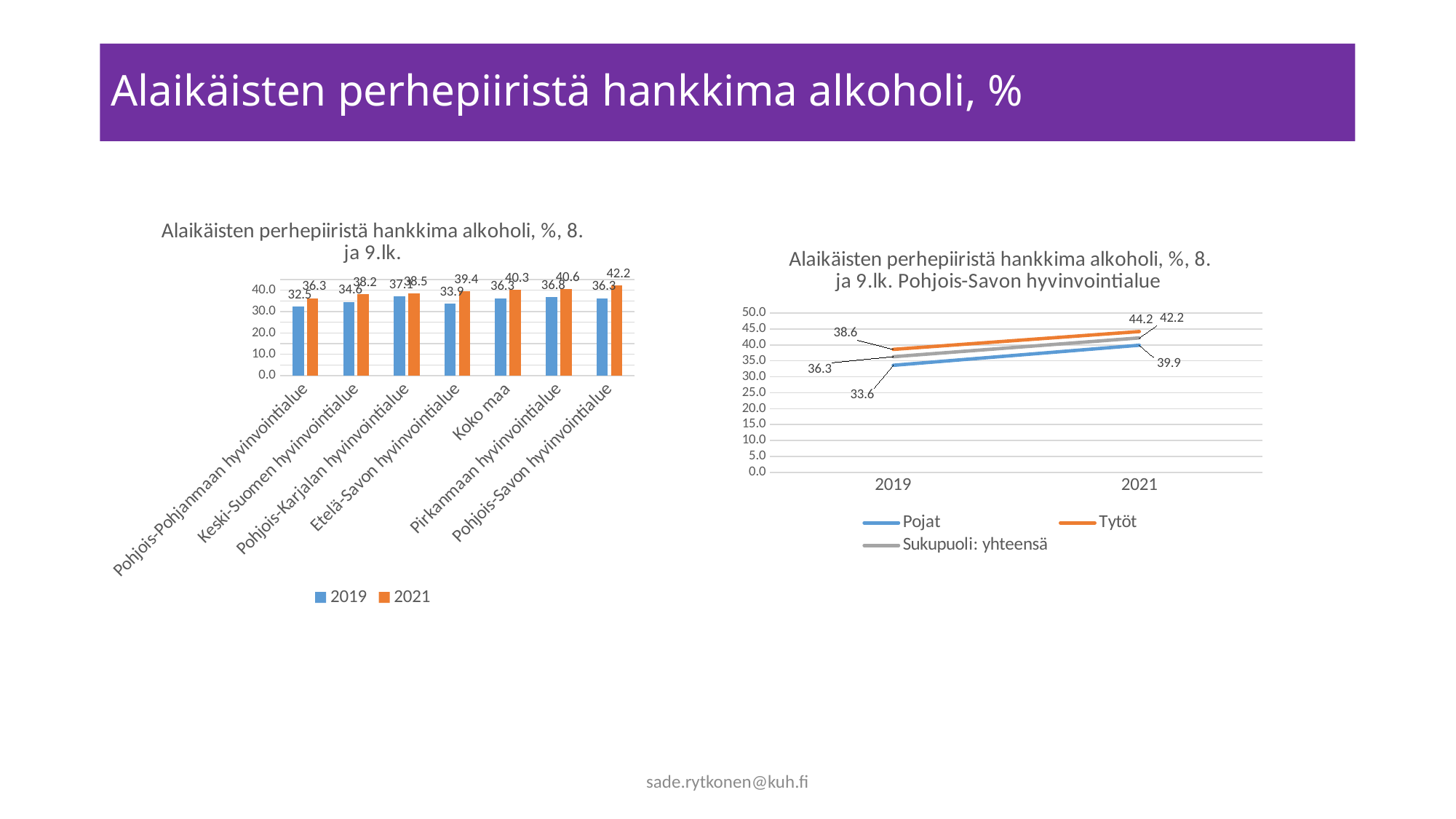
In the left chart, how many categories are shown on the x axis? 7 In the left chart, is the 2021 value for Koko maa greater or less than 40.0? greater What kind of chart is the chart on the right? line chart In the right chart, how many series does the legend list? 3 In the left chart, what is the 2019 value for Pohjois-Pohjanmaan hyvinvointialue? 32.5 In the right chart, what is the value for Tytöt in 2021? 44.2 In the left chart, which category has the highest 2021 value? Pohjois-Savon hyvinvointialue In the right chart, does the Pojat line rise or fall from 2019 to 2021? rise In the left chart, which category has the lowest 2019 value? Pohjois-Pohjanmaan hyvinvointialue In the right chart, what is the value for Pojat in 2019? 33.6 In the left chart, what is the difference between the 2021 and 2019 values for Etelä-Savon hyvinvointialue? 5.5 In the left chart, what is the 2021 value for Pohjois-Savon hyvinvointialue? 42.2